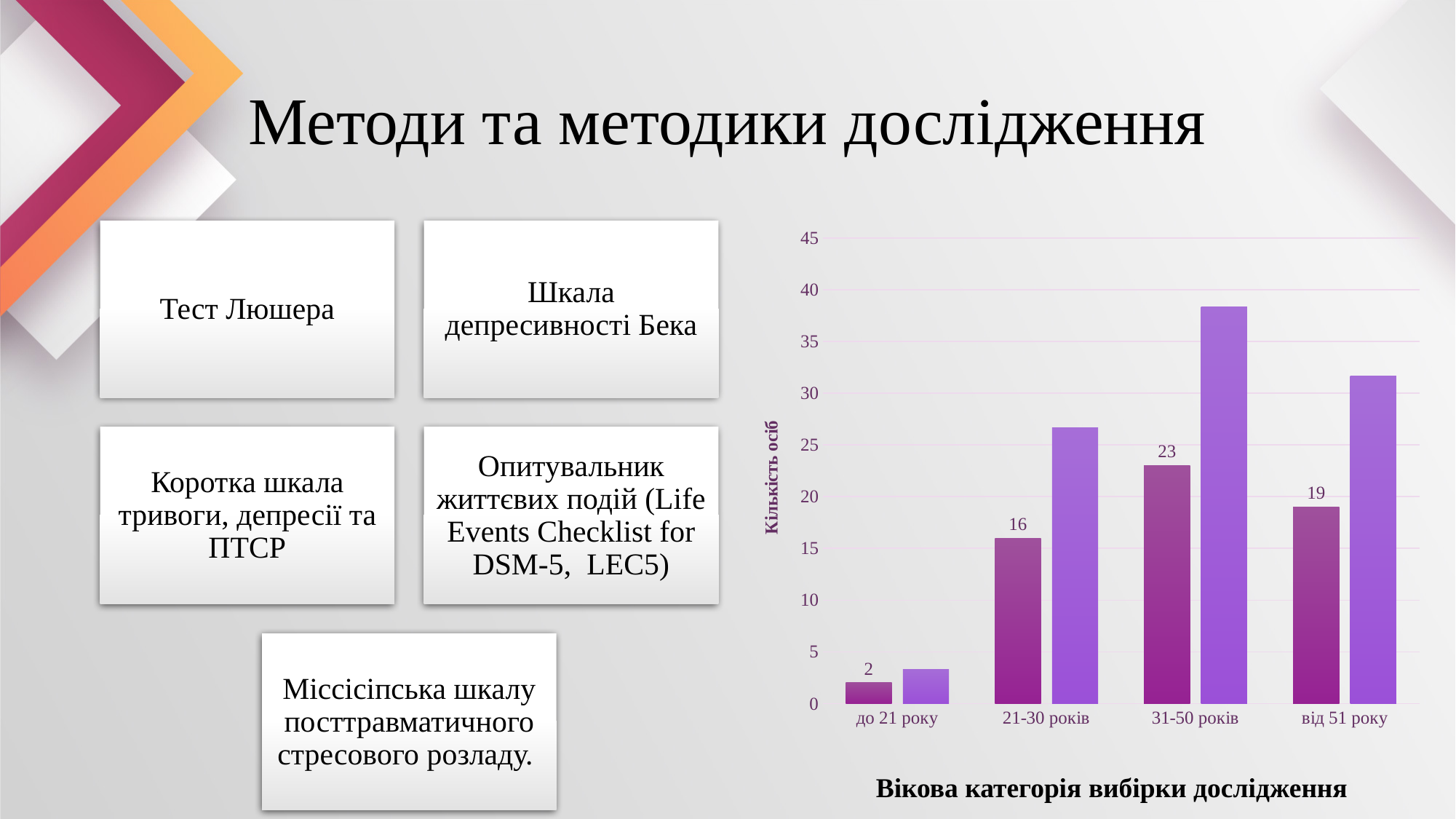
Which labelled value is larger: від 51 року or 21-30 років? від 51 року How many age categories are shown on the x axis of the chart? 4 Is the value of the lighter (second) bar for 31-50 років greater or less than 35? greater Is the value of the lighter (second) bar for до 21 року greater or less than 5? less What is the value of the labelled (darker) bar for the від 51 року category? 19 What is the value of the labelled (darker) bar for the 31-50 років category? 23 Among the labelled (darker) bars, which age category has the lowest value? до 21 року What is the value of the labelled (darker) bar for the до 21 року category? 2 What is the difference between the labelled values for 31-50 років and 21-30 років? 7 What is the value of the labelled (darker) bar for the 21-30 років category? 16 What type of chart is shown on the slide? Bar chart Among the labelled (darker) bars, which age category has the highest value? 31-50 років